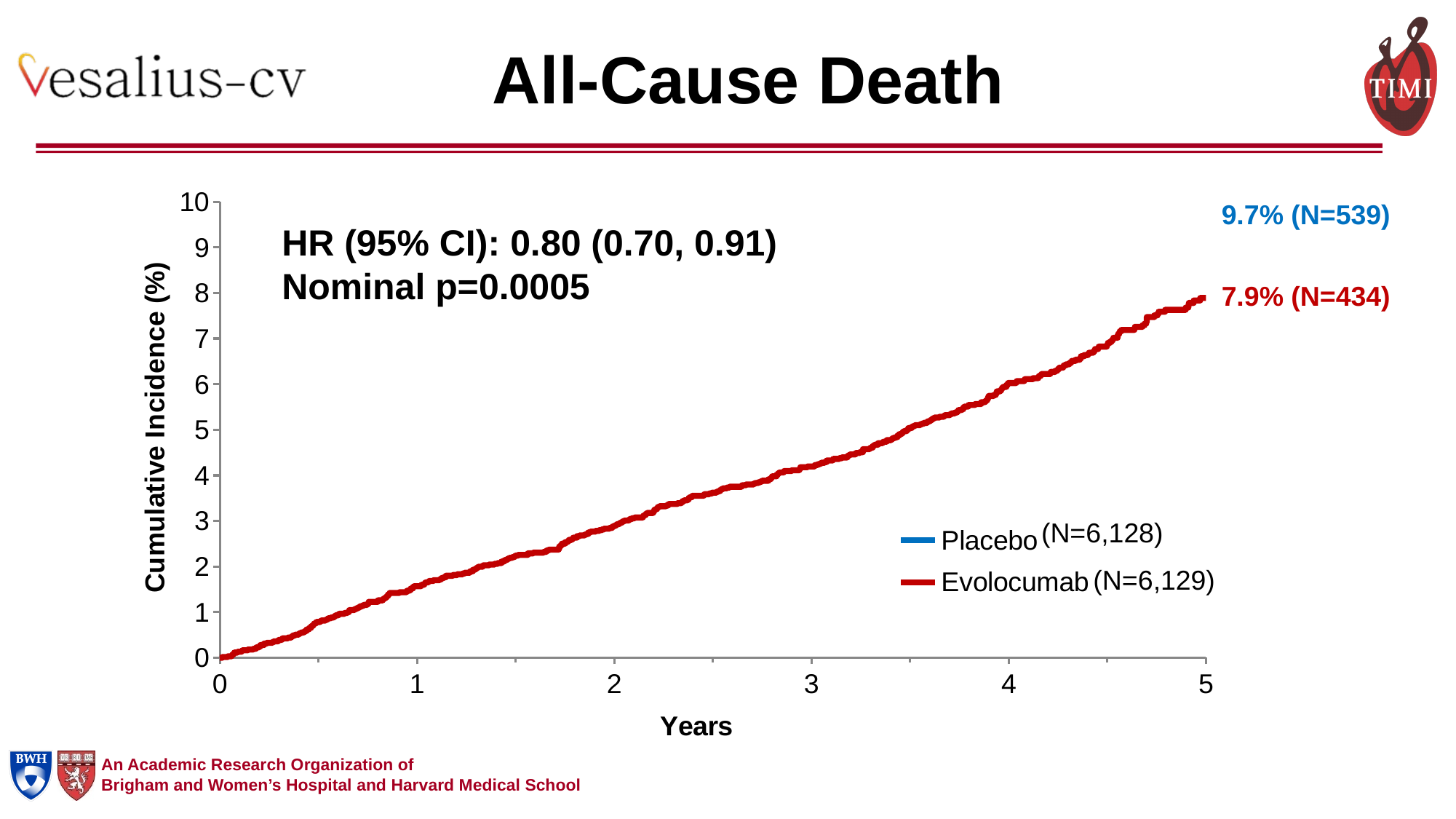
What is the difference in cumulative incidence between the Placebo and Evolocumab groups at the end of follow-up? 1.8% Which group has the higher cumulative incidence of all-cause death, Placebo or Evolocumab? Placebo What kind of chart is shown on the slide? Line chart How many series does the legend list? 2 How many all-cause deaths (N) occurred in the Evolocumab group? 434 What is the label of the y axis? Cumulative Incidence (%) What is the hazard ratio (95% CI) shown on the chart? 0.80 (0.70, 0.91) What is the cumulative incidence of all-cause death at the end of follow-up for the Evolocumab group? 7.9% What is the cumulative incidence of all-cause death at the end of follow-up for the Placebo group? 9.7% Does the Evolocumab cumulative incidence curve rise or fall over the years? Rise How many all-cause deaths (N) occurred in the Placebo group? 539 Is the cumulative incidence for Evolocumab at year 1 greater or less than 2%? less